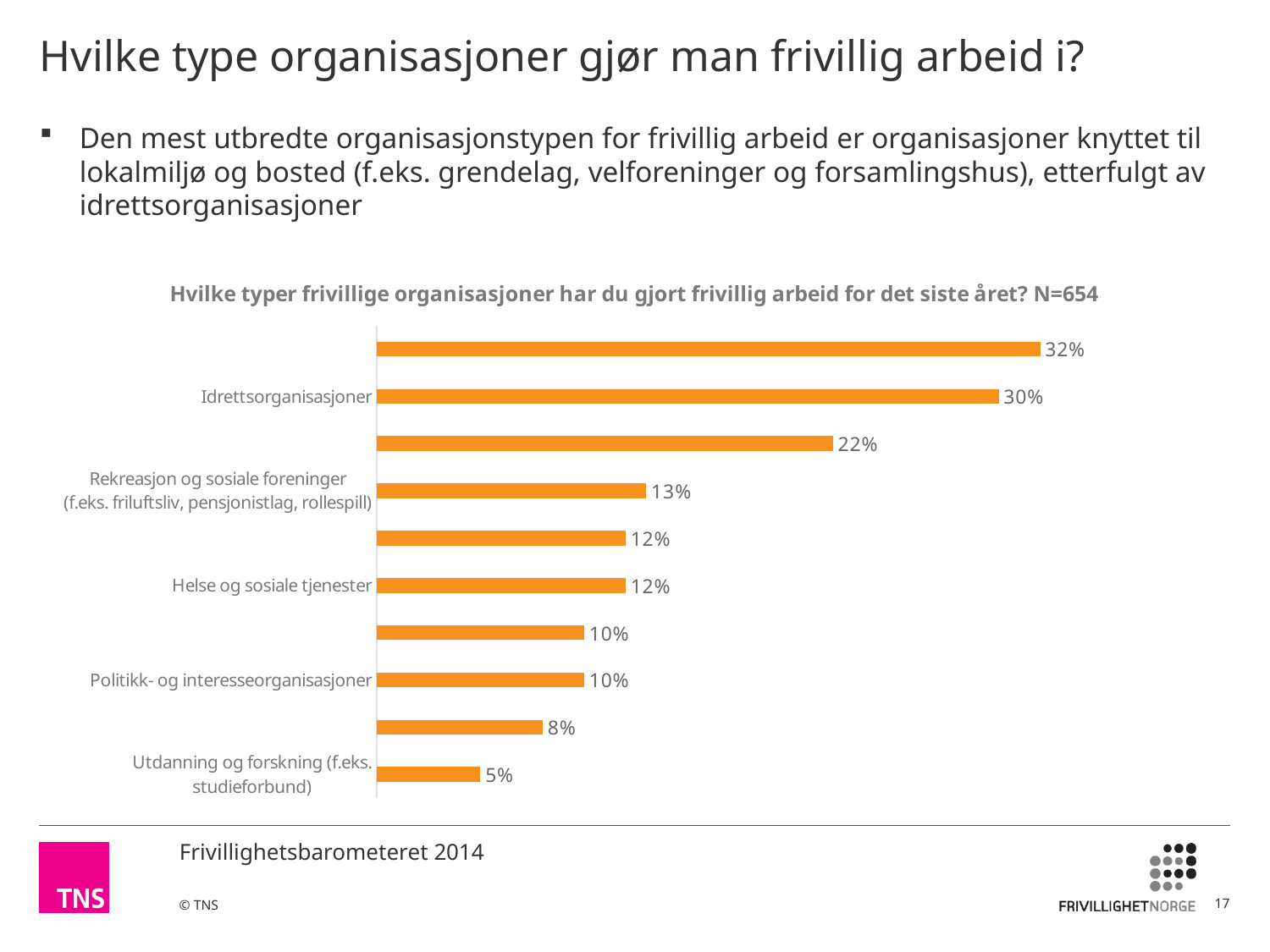
What type of chart is shown on the slide? bar chart Which labelled category has the lowest value in the chart? Utdanning og forskning (f.eks. studieforbund) What is the value for Utdanning og forskning (f.eks. studieforbund)? 5% What is the value for Politikk- og interesseorganisasjoner? 10% What sample size (N) is stated in the chart title? N=654 What is the value for Helse og sosiale tjenester? 12% How many bars are plotted in the chart? 10 What is the value for Idrettsorganisasjoner? 30% What is the value for Rekreasjon og sosiale foreninger (f.eks. friluftsliv, pensjonistlag, rollespill)? 13% What is the highest value shown in the chart? 32% Which is larger, the value for Rekreasjon og sosiale foreninger or the value for Politikk- og interesseorganisasjoner? Rekreasjon og sosiale foreninger What is the difference between the values for Idrettsorganisasjoner and Utdanning og forskning (f.eks. studieforbund)? 25 percentage points